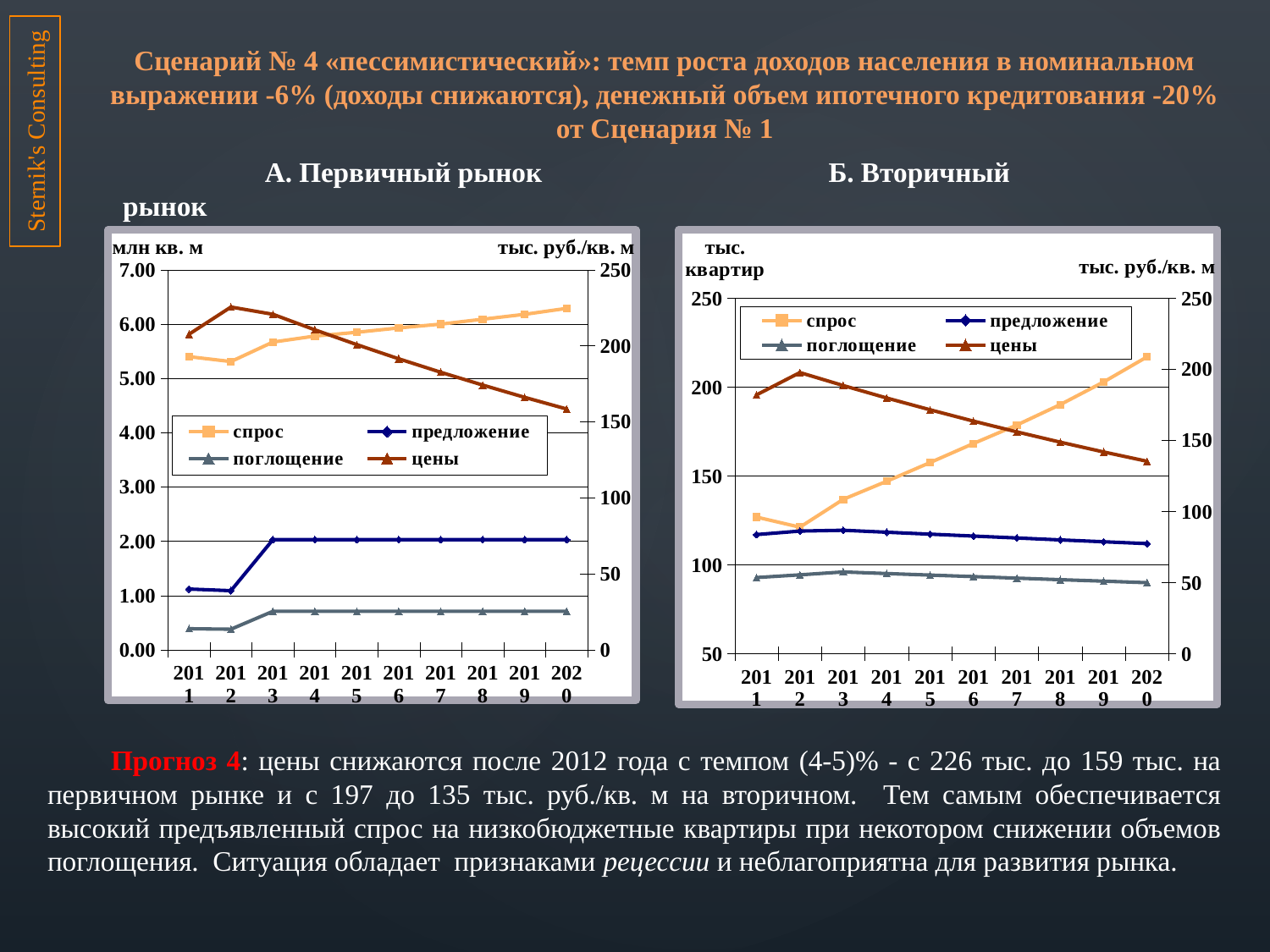
In the chart «А. Первичный рынок», is the value for «предложение» in 2015 greater or less than 1.00? greater How many series does the legend of the chart «Б. Вторичный рынок» list? 4 How many years are shown on the x axis of the chart «А. Первичный рынок»? 10 What kind of chart is the chart titled «А. Первичный рынок»? line chart In the chart «А. Первичный рынок», which is larger in 2020: «спрос» or «предложение»? спрос In the chart «А. Первичный рынок», does the «спрос» series rise or fall from 2013 to 2020? rise In the chart «Б. Вторичный рынок», is the value for «поглощение» in 2011 greater or less than 100? less In the chart «Б. Вторичный рынок», is the value for «спрос» in 2020 greater or less than 200? greater In the chart «Б. Вторичный рынок», does the «цены» series rise or fall from 2012 to 2020? fall In the chart «Б. Вторичный рынок», which is larger in 2011: «предложение» or «поглощение»? предложение What is the unit label on the left vertical axis of the chart «Б. Вторичный рынок»? тыс. квартир